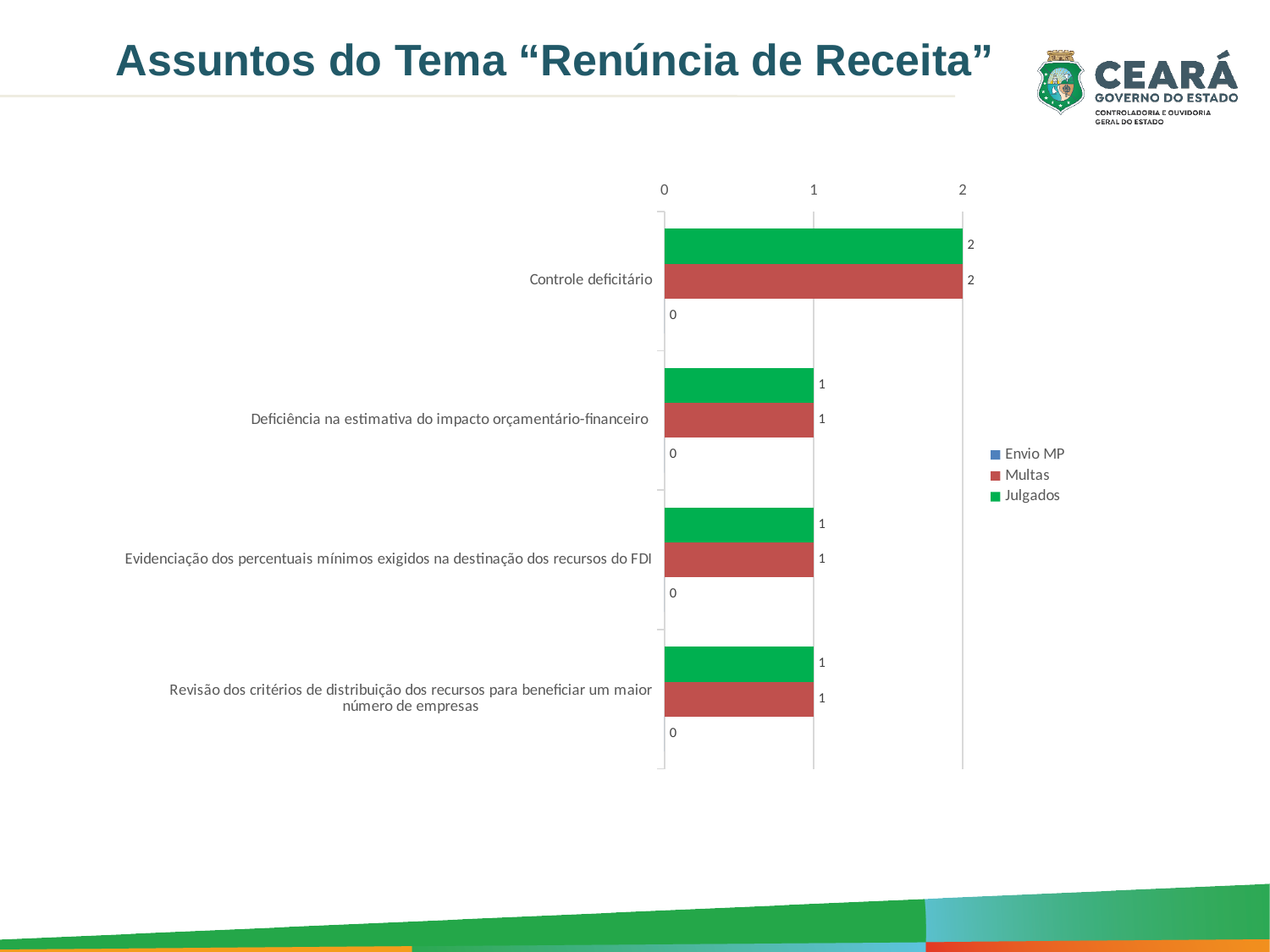
What kind of chart is shown on the slide? bar chart How many categories are shown on the chart? 4 What is the Envio MP value for Controle deficitário? 0 Which series is shown in green in the legend? Julgados Which category has the highest Julgados value? Controle deficitário Which is larger: the Multas value for Controle deficitário or the Multas value for Deficiência na estimativa do impacto orçamentário-financeiro? Controle deficitário What is the Multas value for Controle deficitário? 2 What is the Multas value for Evidenciação dos percentuais mínimos exigidos na destinação dos recursos do FDI? 1 How many series does the legend list? 3 What is the Julgados value for Deficiência na estimativa do impacto orçamentário-financeiro? 1 What is the difference between the Julgados value for Controle deficitário and the Julgados value for Revisão dos critérios de distribuição dos recursos para beneficiar um maior número de empresas? 1 What is the Julgados value for Controle deficitário? 2